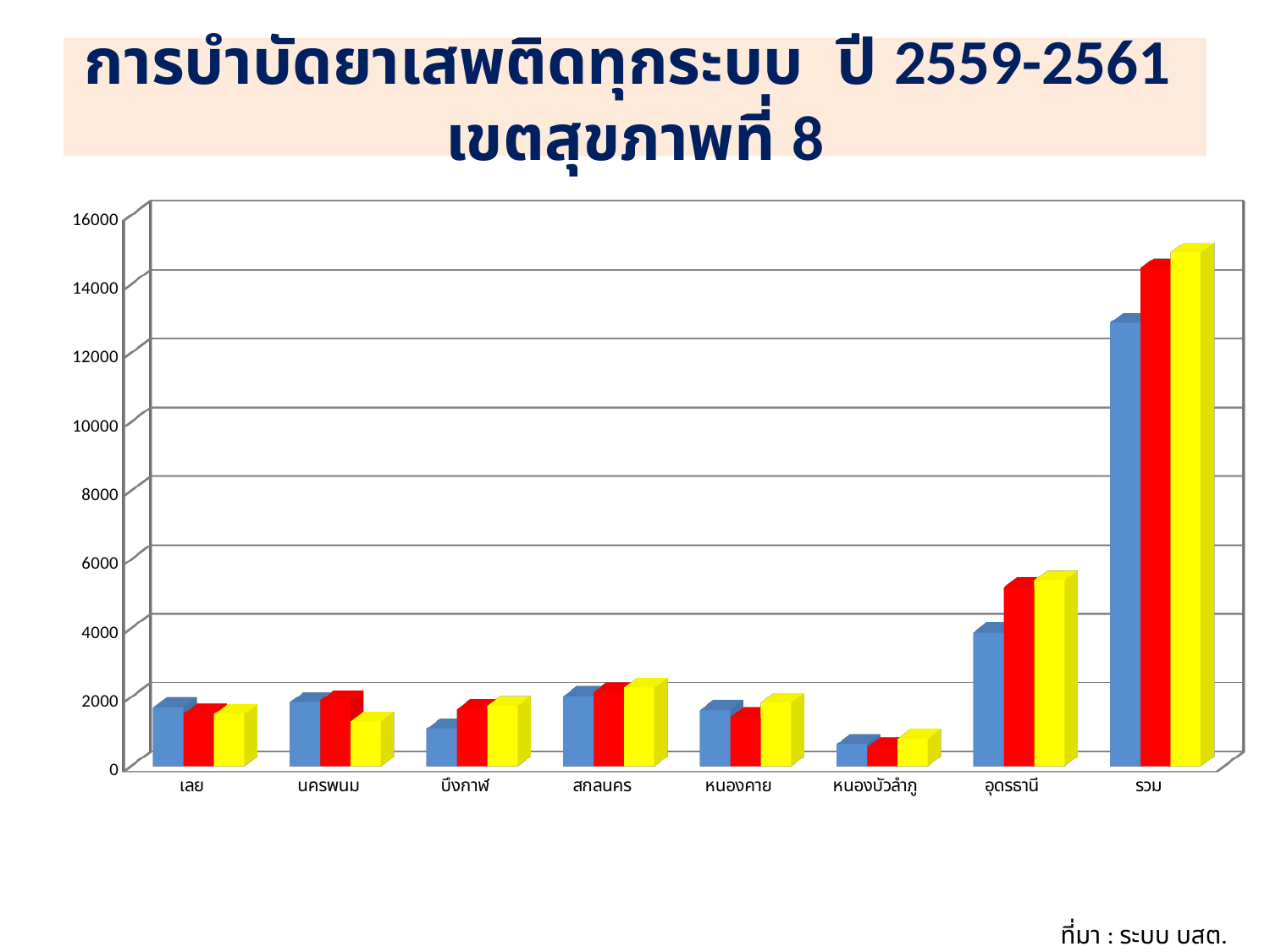
Excluding รวม, which province has the tallest bars in the chart? อุดรธานี Is the value of the yellow bar for รวม greater or less than 14000? greater How many categories are shown along the x axis of the chart? 8 Is the value of the blue bar for รวม greater or less than 12000? greater Which category has the tallest bars in the chart? รวม How many bars are plotted for each category in the chart? 3 Which category has the lowest bars in the chart? หนองบัวลำภู What is the title of the chart on the slide? การบำบัดยาเสพติดทุกระบบ ปี 2559-2561 เขตสุขภาพที่ 8 Is the value of the yellow bar for อุดรธานี greater or less than 4000? greater For อุดรธานี, which is larger: the blue bar or the yellow bar? the yellow bar What kind of chart is shown on the slide? bar chart